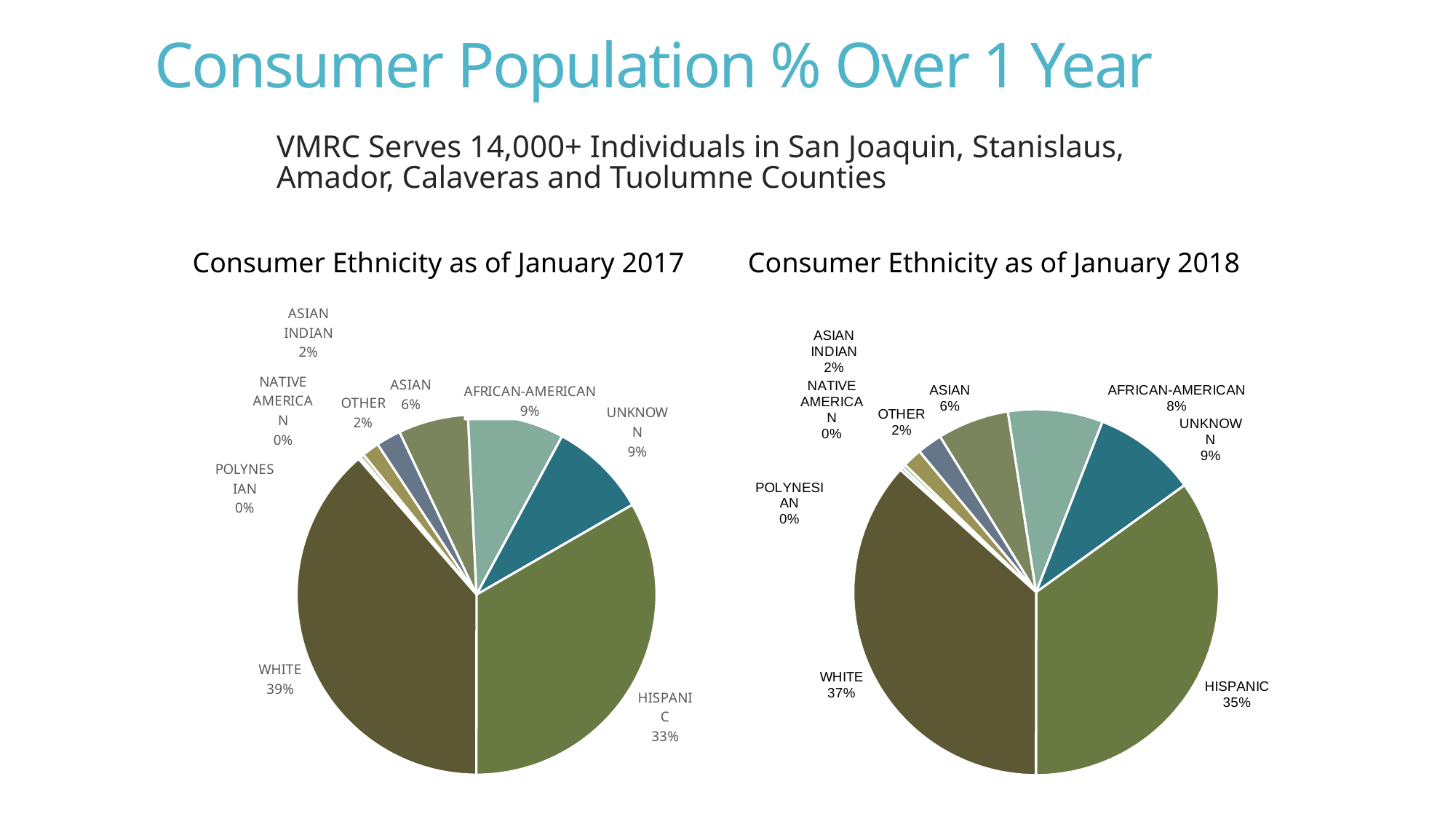
In the 'Consumer Ethnicity as of January 2018' chart, which is larger, the share for UNKNOWN or the share for ASIAN? UNKNOWN What is the title of the slide? Consumer Population % Over 1 Year How many categories are labelled in the 'Consumer Ethnicity as of January 2018' chart? 9 In the 'Consumer Ethnicity as of January 2017' chart, what percentage is labelled for UNKNOWN? 9% In the 'Consumer Ethnicity as of January 2017' chart, what is the difference in percentage points between WHITE and HISPANIC? 6 In the 'Consumer Ethnicity as of January 2018' chart, what percentage is labelled for HISPANIC? 35% What kind of chart is used for 'Consumer Ethnicity as of January 2017'? pie chart In the 'Consumer Ethnicity as of January 2018' chart, which category has the largest share? WHITE In the 'Consumer Ethnicity as of January 2017' chart, what percentage is labelled for WHITE? 39% In the 'Consumer Ethnicity as of January 2017' chart, what percentage is labelled for ASIAN? 6% In the 'Consumer Ethnicity as of January 2018' chart, what percentage is labelled for AFRICAN-AMERICAN? 8% In the 'Consumer Ethnicity as of January 2017' chart, which category has the largest share? WHITE